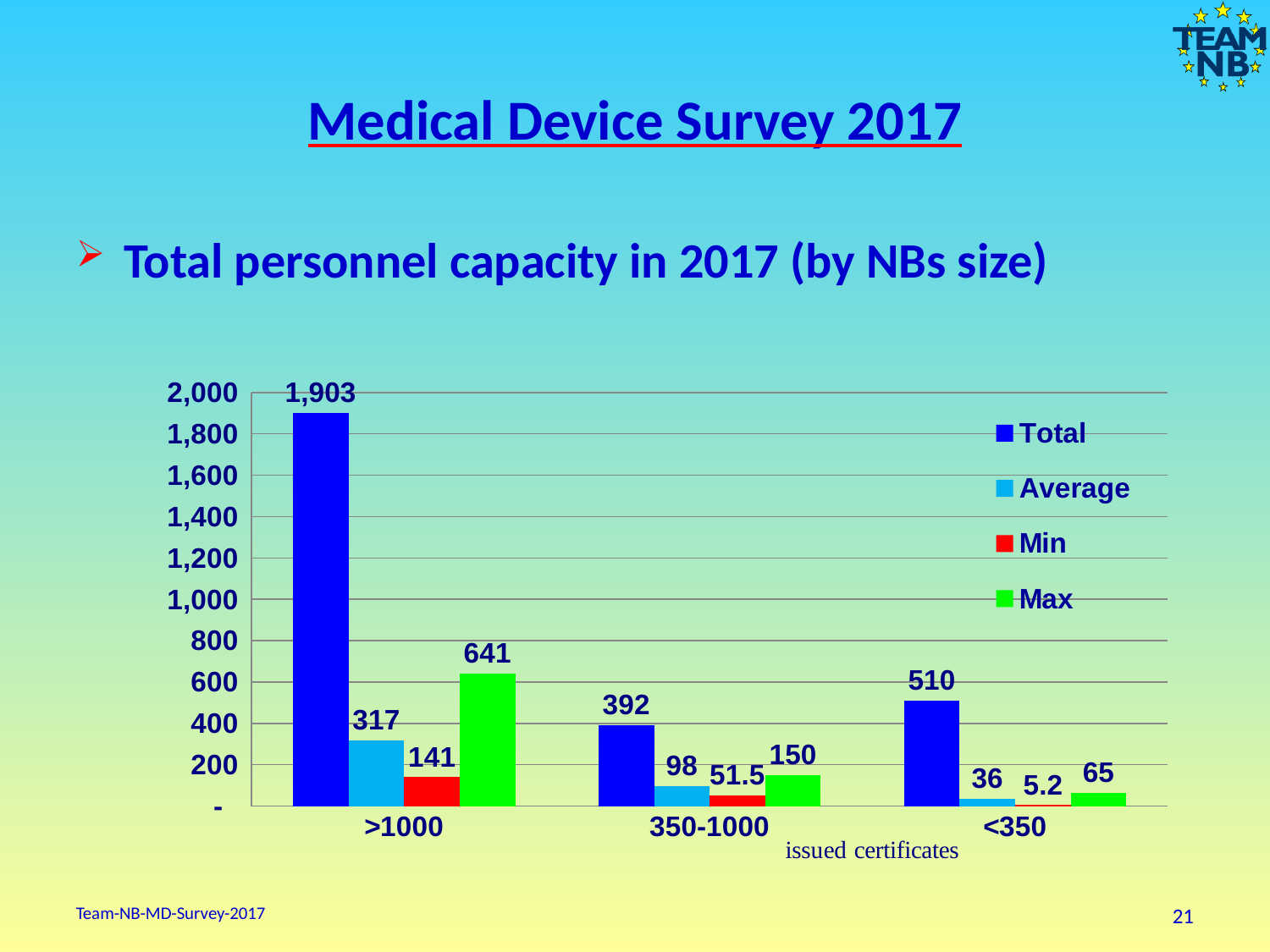
Which is larger, the Total for 350-1000 or the Total for <350? <350 What is the Average value for the 350-1000 category? 98 Is the Max value for 350-1000 greater or less than 200? less What is the Min value for the <350 category? 5.2 Which category has the highest Total value? >1000 How many categories are shown on the x axis? 3 What kind of chart is shown on the slide? Bar chart Which category has the lowest Max value? <350 What is the Max value for the >1000 category? 641 What is the Total personnel capacity for NBs with >1000 issued certificates? 1,903 What is the difference between the Total values for >1000 and 350-1000? 1,511 How many series does the legend list? 4